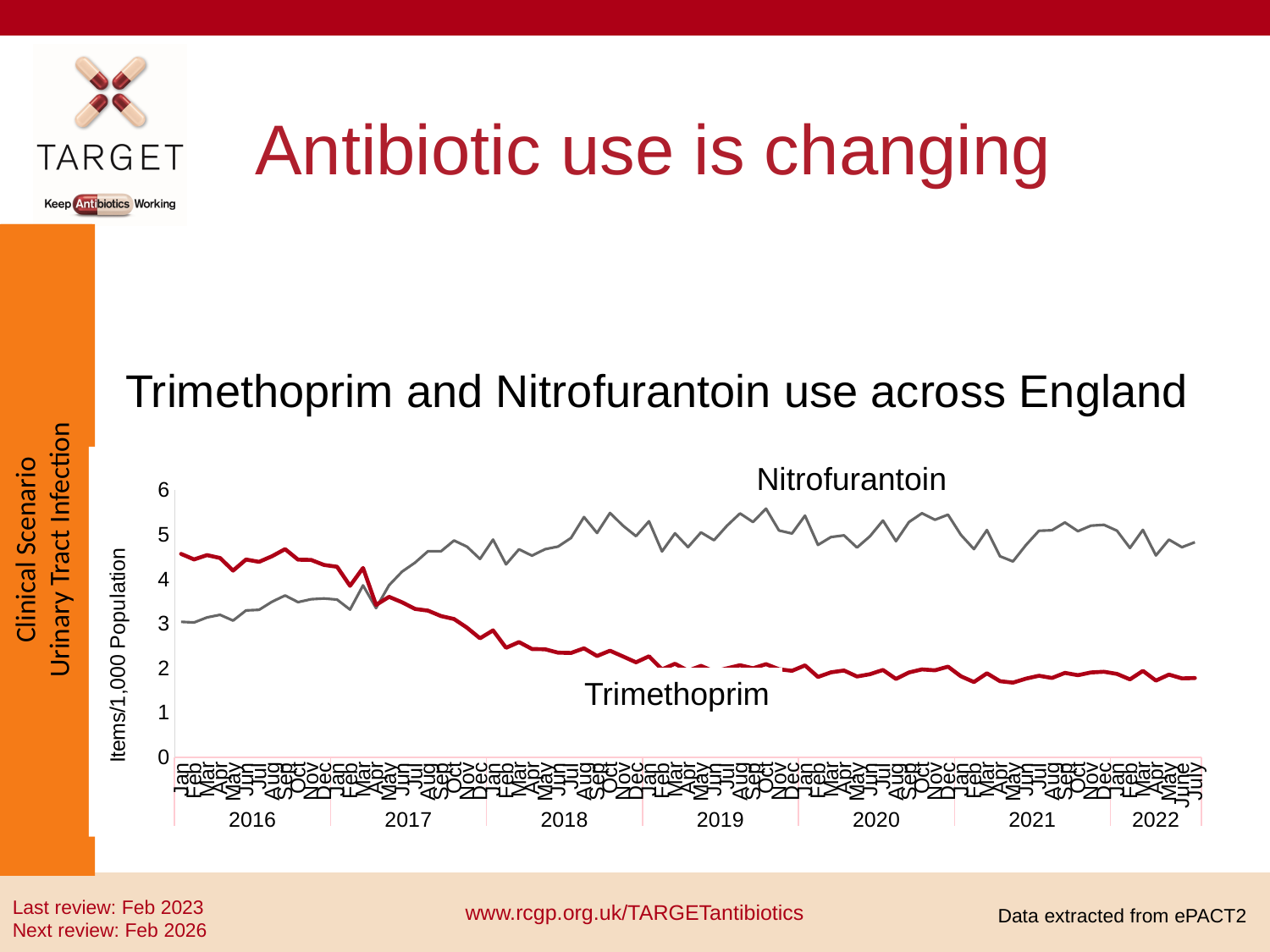
Does Trimethoprim use rise or fall from 2016 to 2022? fall Is the value for Trimethoprim in January 2016 greater or less than 4? greater How many years are labelled along the x axis of the chart? 7 Does Nitrofurantoin use rise or fall from 2016 to 2019? rise What kind of chart is shown on the slide? line chart What is the title of the chart? Trimethoprim and Nitrofurantoin use across England Which series has the higher value at the start of 2016, Trimethoprim or Nitrofurantoin? Trimethoprim Is the value for Nitrofurantoin in January 2016 greater or less than 4? less How many series are plotted on the chart? 2 What is the label on the y axis of the chart? Items/1,000 Population Is the value for Trimethoprim in July 2022 greater or less than 2? less Which series has the higher value in 2022, Trimethoprim or Nitrofurantoin? Nitrofurantoin